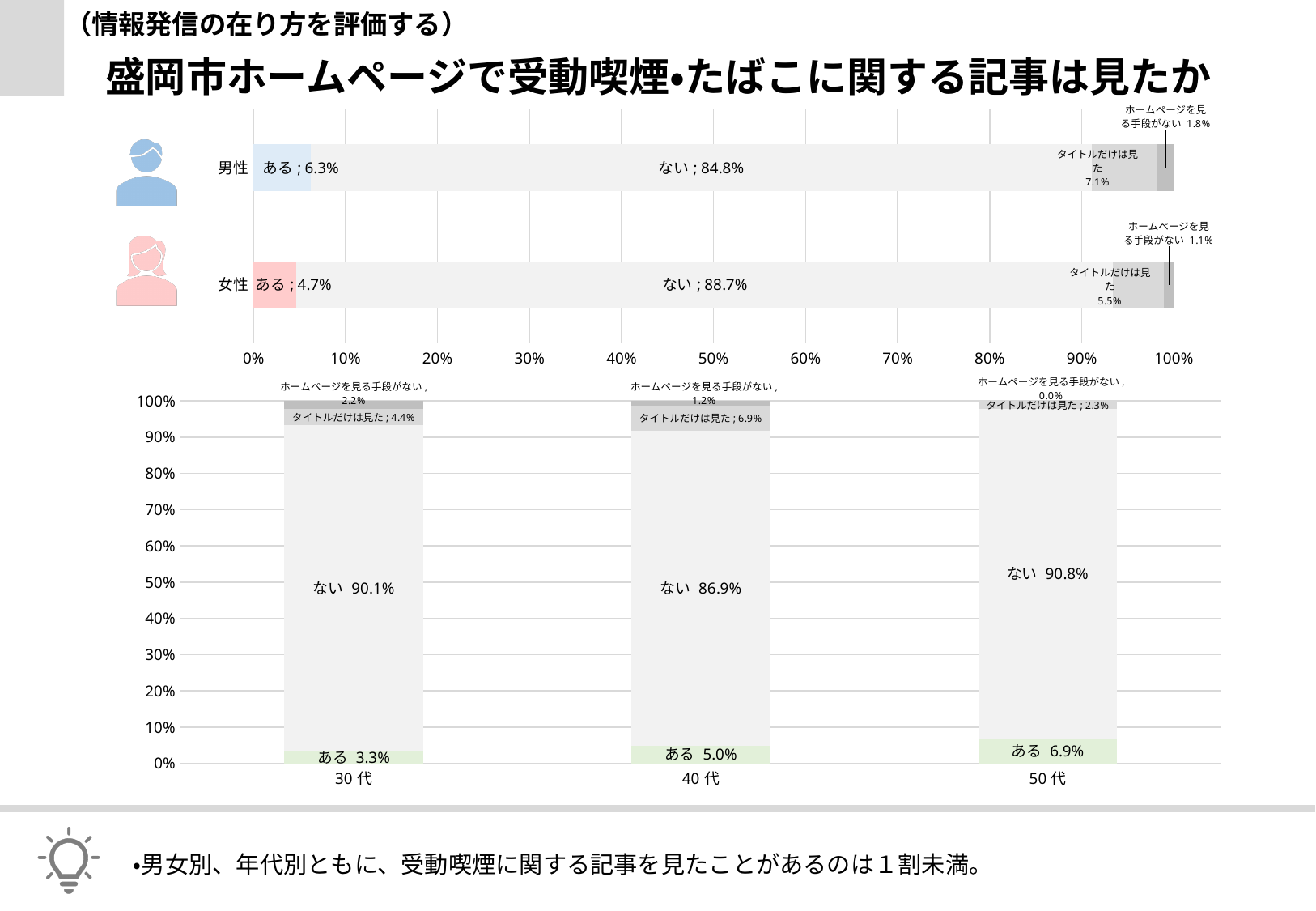
In the bottom chart by age group, which age group has the highest ある value? 50代 In the top chart by gender, what is the value of ある for 男性? 6.3% In the top chart by gender, what is the value of タイトルだけは見た for 男性? 7.1% In the bottom chart by age group, how many age groups are shown? 3 What kind of chart is the bottom chart by age group? Stacked bar chart In the bottom chart by age group, what is the value of タイトルだけは見た for 30代? 4.4% In the bottom chart by age group, what is the value of ない for 40代? 86.9% In the top chart by gender, what is the value of ホームページを見る手段がない for 女性? 1.1% In the bottom chart by age group, what is the value of ある for 50代? 6.9% In the top chart by gender, what is the difference between the ない values for 女性 and 男性? 3.9% In the top chart by gender, which group has the larger ある value, 男性 or 女性? 男性 In the top chart by gender, what is the value of ない for 女性? 88.7%